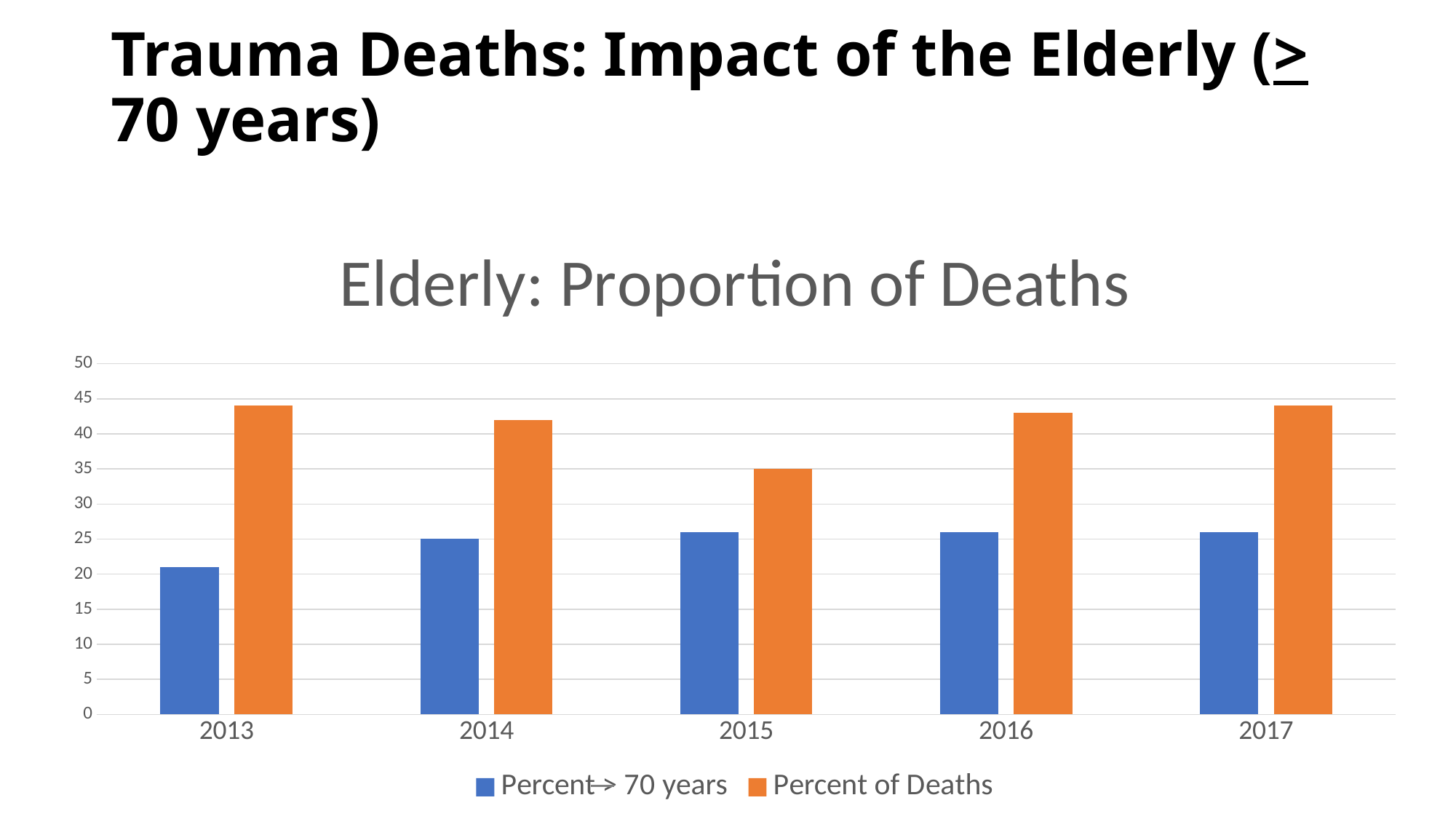
Does the Percent of Deaths series rise or fall from 2013 to 2015? fall In which year is the Percent of Deaths value lowest? 2015 Is the Percent > 70 years value for 2015 greater or less than 30? less Which series is shown in orange? Percent of Deaths How many series does the legend list? 2 In which year is the Percent > 70 years value lowest? 2013 What is the title of the chart? Elderly: Proportion of Deaths How many years are shown on the x axis? 5 Is the Percent > 70 years value for 2013 greater or less than 25? less What kind of chart is shown on the slide? Bar chart In 2013, which is larger: Percent > 70 years or Percent of Deaths? Percent of Deaths Is the Percent of Deaths value for 2013 greater or less than 40? greater